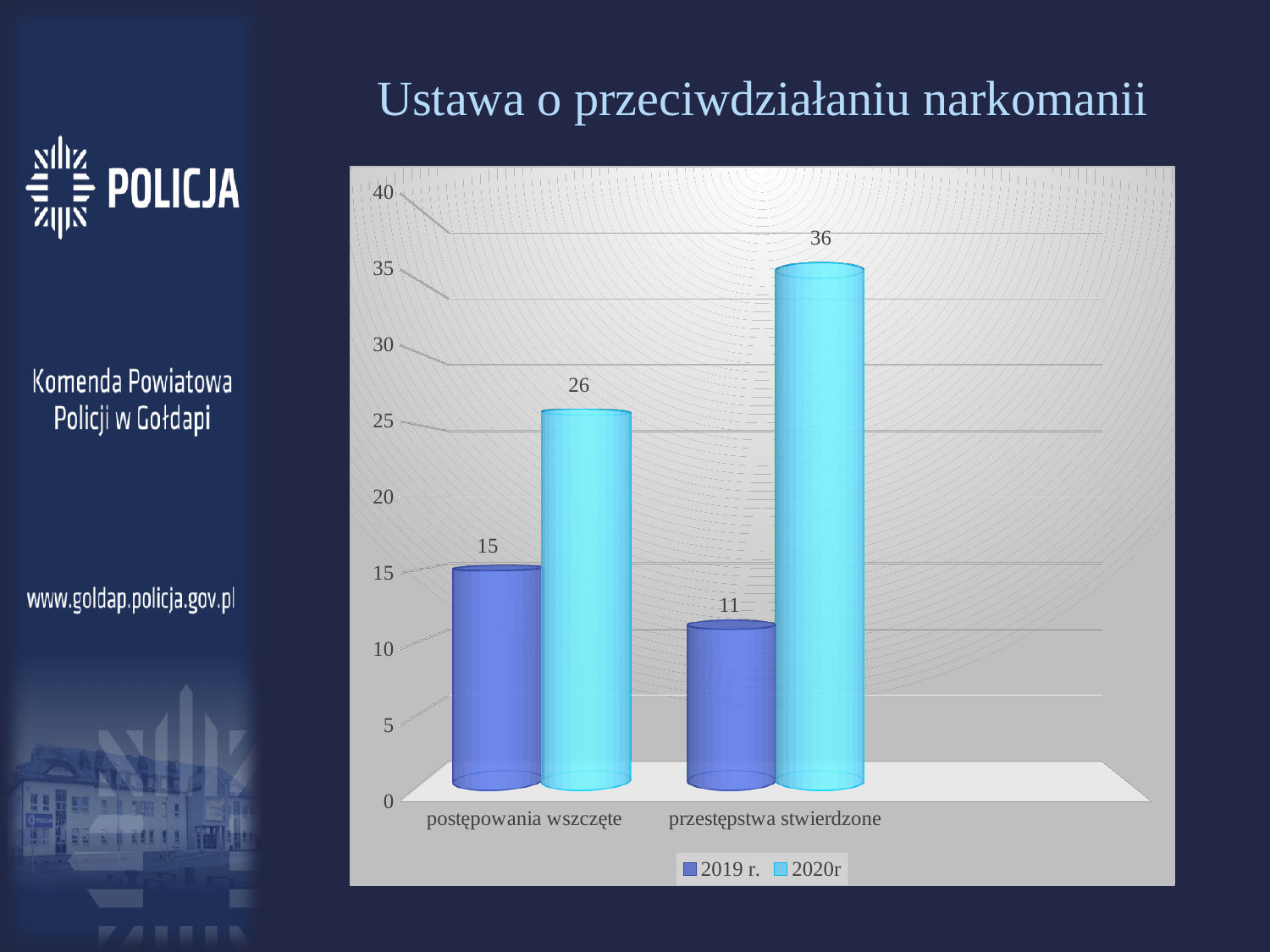
Which is larger: the 2019 r. value for postępowania wszczęte or the 2019 r. value for przestępstwa stwierdzone? postępowania wszczęte How many categories are shown on the x axis? 2 How many series does the legend list? 2 Which category has the highest value for the 2020r series? przestępstwa stwierdzone What is the value for 2020r in the category przestępstwa stwierdzone? 36 What is the value for 2020r in the category postępowania wszczęte? 26 What is the value for 2019 r. in the category przestępstwa stwierdzone? 11 What is the value for 2019 r. in the category postępowania wszczęte? 15 What is the difference between the 2020r and 2019 r. values for postępowania wszczęte? 11 What kind of chart is shown on the slide? bar chart Which category has the lowest value for the 2019 r. series? przestępstwa stwierdzone What is the difference between the 2020r and 2019 r. values for przestępstwa stwierdzone? 25